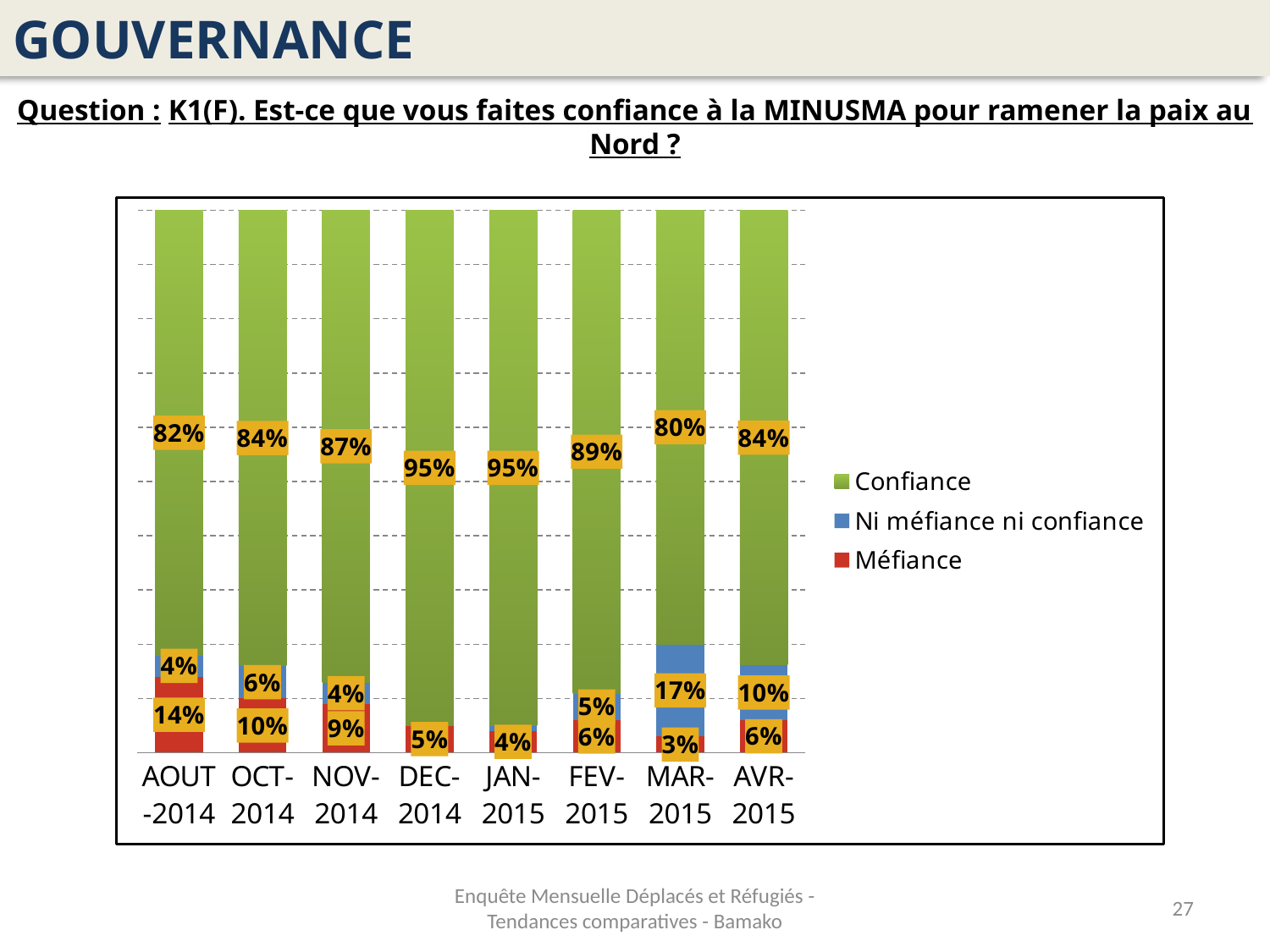
Which month has the lowest Confiance value? MAR-2015 How many series does the legend list? 3 What is the 'Ni méfiance ni confiance' value for MAR-2015? 17% Which series is shown in green in the legend? Confiance Which month has the highest Méfiance value? AOUT-2014 What is the total of the three labelled segments for the AVR-2015 bar? 100% What is the Confiance value for DEC-2014? 95% What kind of chart is shown on the slide? Stacked bar chart What is the difference between the Confiance values for JAN-2015 and AVR-2015? 11% Which is larger, the Méfiance value for OCT-2014 or for NOV-2014? OCT-2014 How many months are shown on the x axis? 8 What is the Méfiance value for AOUT-2014? 14%